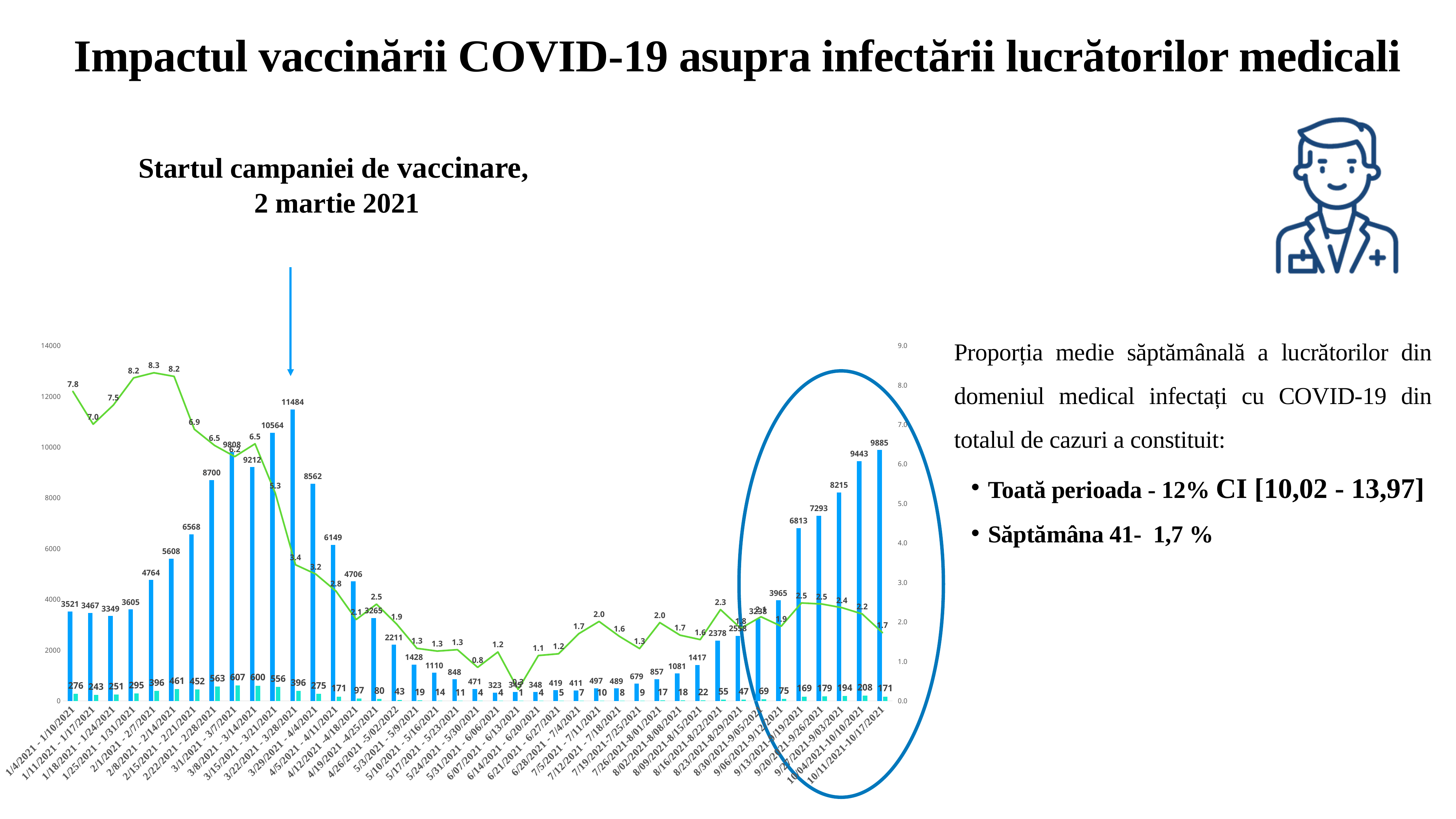
What kind of chart is shown on the slide? Combined bar and line chart Is the tall blue bar for 9/13/2021 - 9/19/2021 greater or less than 6000? greater What is the lowest value labelled on the green line? 0.3 What value does the green line show for the week 1/4/2021 - 1/10/2021? 7.8 What is the value of the tall blue bar for the week 3/22/2021 - 3/28/2021? 11484 Which is larger, the tall blue bar for 2/22/2021 - 2/28/2021 or for 3/29/2021 - 4/4/2021? 2/22/2021 - 2/28/2021 What value does the green line show for the last week, 10/11/2021 - 10/17/2021? 1.7 Which week has the highest tall blue bar? 3/22/2021 - 3/28/2021 How many weekly categories are shown on the x axis? 41 What is the difference between the tall blue bar values for 3/22/2021 - 3/28/2021 and 3/15/2021 - 3/21/2021? 920 What is the highest value shown on the green line? 8.3 What is the value of the tall blue bar for the week 10/11/2021 - 10/17/2021? 9885